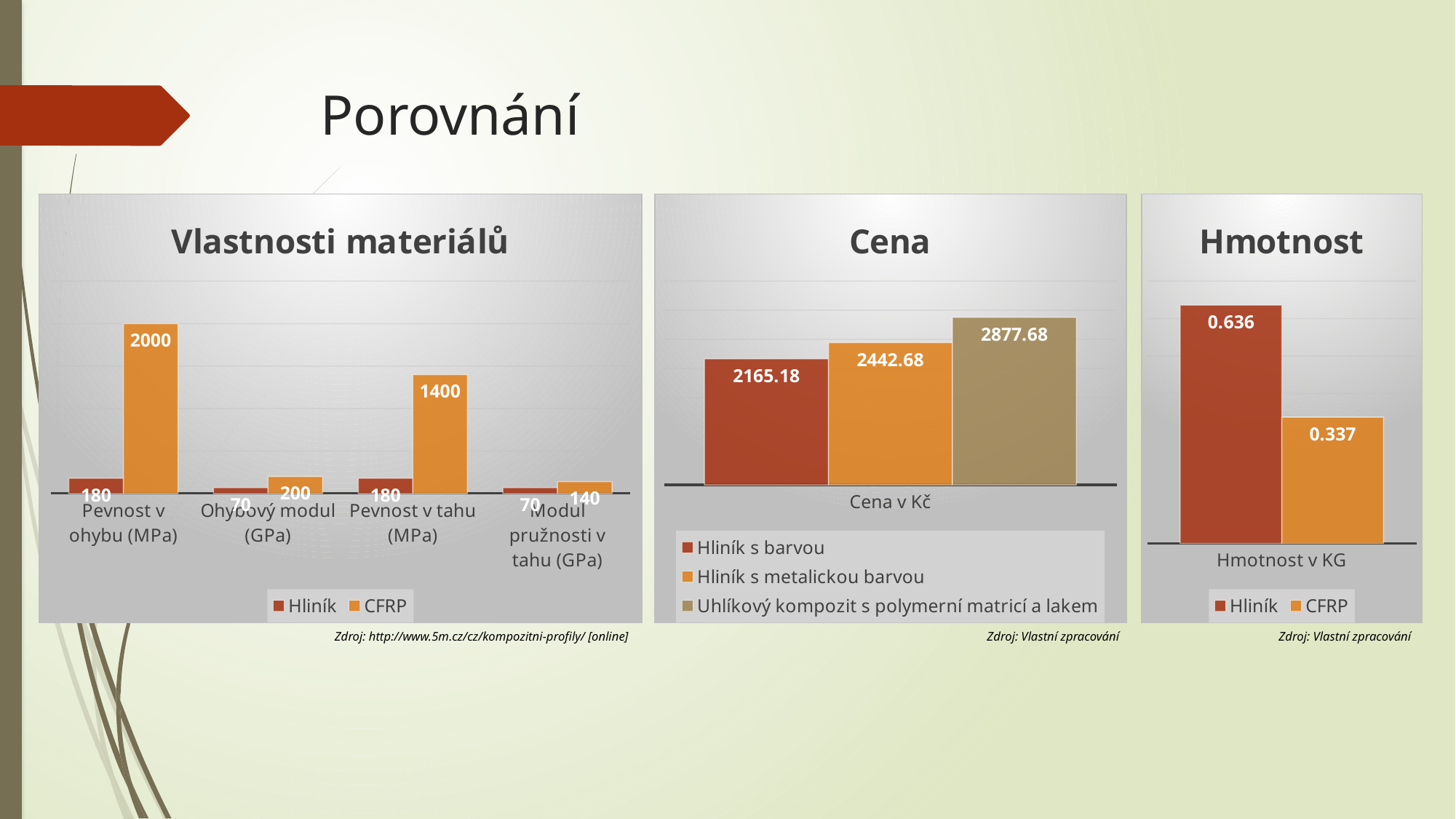
In the 'Hmotnost' chart, what is the value for Hliník? 0.636 What type of chart is the 'Hmotnost' chart? Bar chart In the 'Vlastnosti materiálů' chart, how many series does the legend list? 2 In the 'Vlastnosti materiálů' chart, what is the CFRP value for Pevnost v ohybu (MPa)? 2000 In the 'Hmotnost' chart, which series has the lower value, Hliník or CFRP? CFRP In the 'Cena' chart, what is the value for Hliník s metalickou barvou? 2442.68 In the 'Cena' chart, what is the difference between Uhlíkový kompozit s polymerní matricí a lakem and Hliník s barvou? 712.50 In the 'Cena' chart, what is the x-axis category label? Cena v Kč In the 'Cena' chart, which series has the highest value? Uhlíkový kompozit s polymerní matricí a lakem In the 'Vlastnosti materiálů' chart, what is the difference between the CFRP and Hliník values for Pevnost v tahu (MPa)? 1220 In the 'Vlastnosti materiálů' chart, how many categories are shown on the x axis? 4 In the 'Vlastnosti materiálů' chart, what is the Hliník value for Pevnost v tahu (MPa)? 180